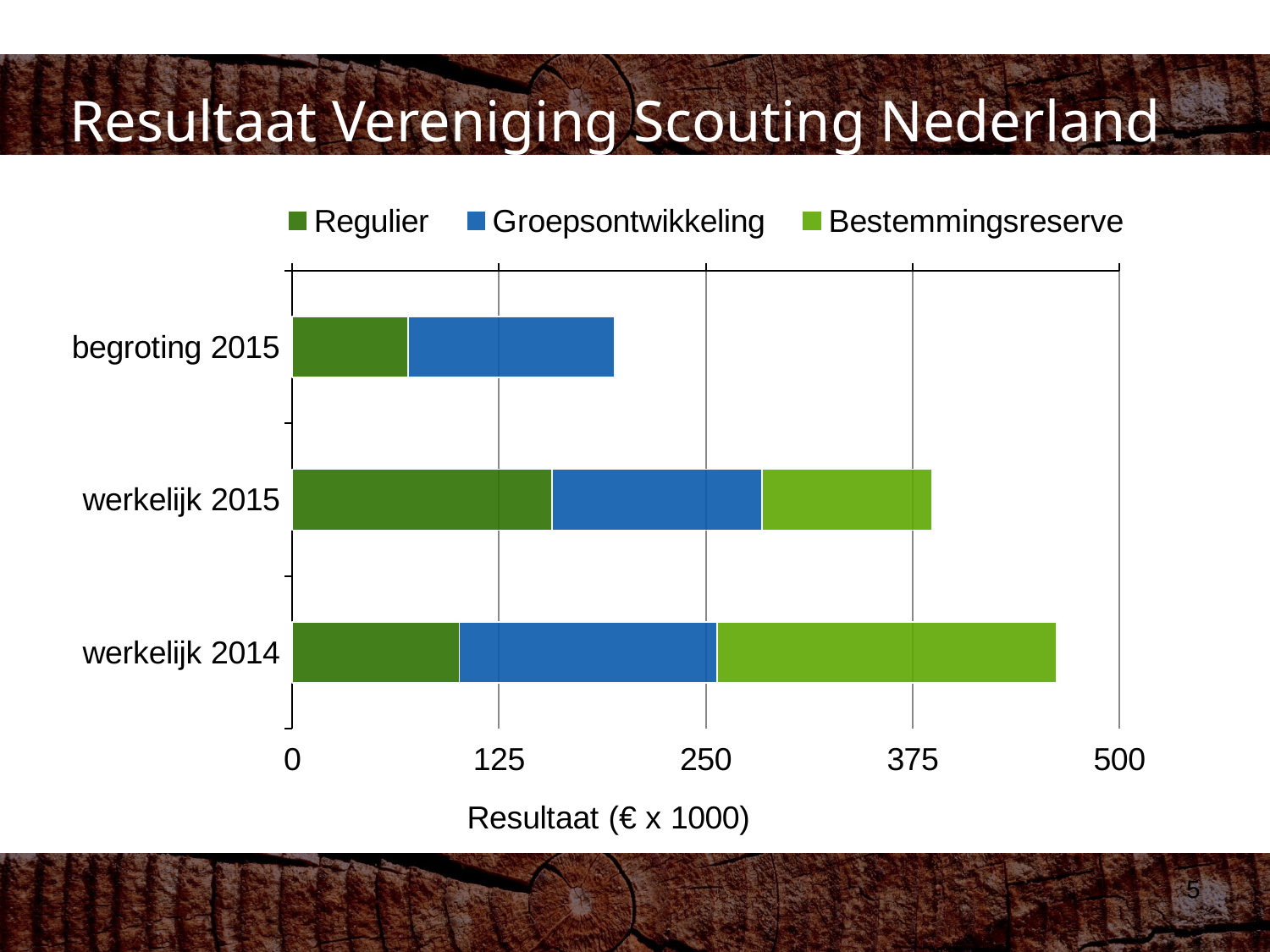
How many categories are shown on the vertical axis of the chart? 3 What kind of chart is shown on the slide? stacked bar chart Is the total bar for begroting 2015 greater or less than 250? less What is the title of the slide containing the chart? Resultaat Vereniging Scouting Nederland How many series does the chart legend list? 3 Which category has the shortest total bar? begroting 2015 Is the Regulier value for begroting 2015 greater or less than 125? less Is the Regulier value for werkelijk 2015 greater or less than 125? greater What is the label of the horizontal axis of the chart? Resultaat (€ x 1000) Which category has the longest total bar? werkelijk 2014 Which category has the larger Bestemmingsreserve segment, werkelijk 2015 or werkelijk 2014? werkelijk 2014